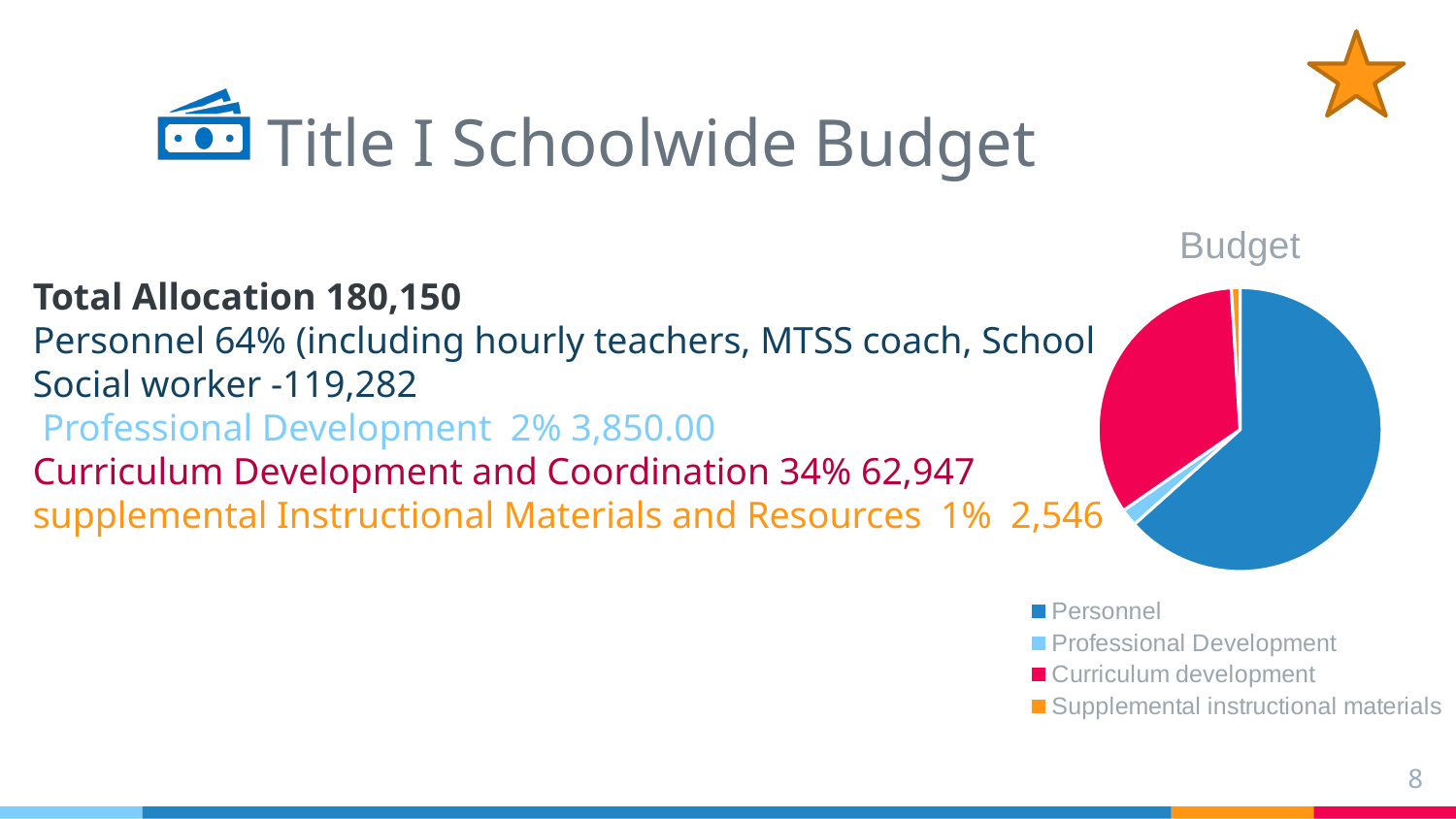
According to the slide, what share of the budget does the Personnel slice represent? 64% How many slices does the "Budget" pie chart have? 4 What is the title of the pie chart on the slide? Budget What colour is the Personnel slice in the "Budget" pie chart? blue According to the slide, what is the amount allocated to Personnel? 119,282 Which category has the largest slice in the "Budget" pie chart? Personnel Which category has the smallest slice in the "Budget" pie chart? Supplemental instructional materials In the "Budget" pie chart, which slice is larger: Professional Development or Supplemental instructional materials? Professional Development According to the slide, what share of the budget does the Curriculum development slice represent? 34% What kind of chart is the "Budget" chart on the slide? pie chart In the "Budget" pie chart, which slice is larger: Personnel or Curriculum development? Personnel How many entries does the legend of the "Budget" pie chart list? 4